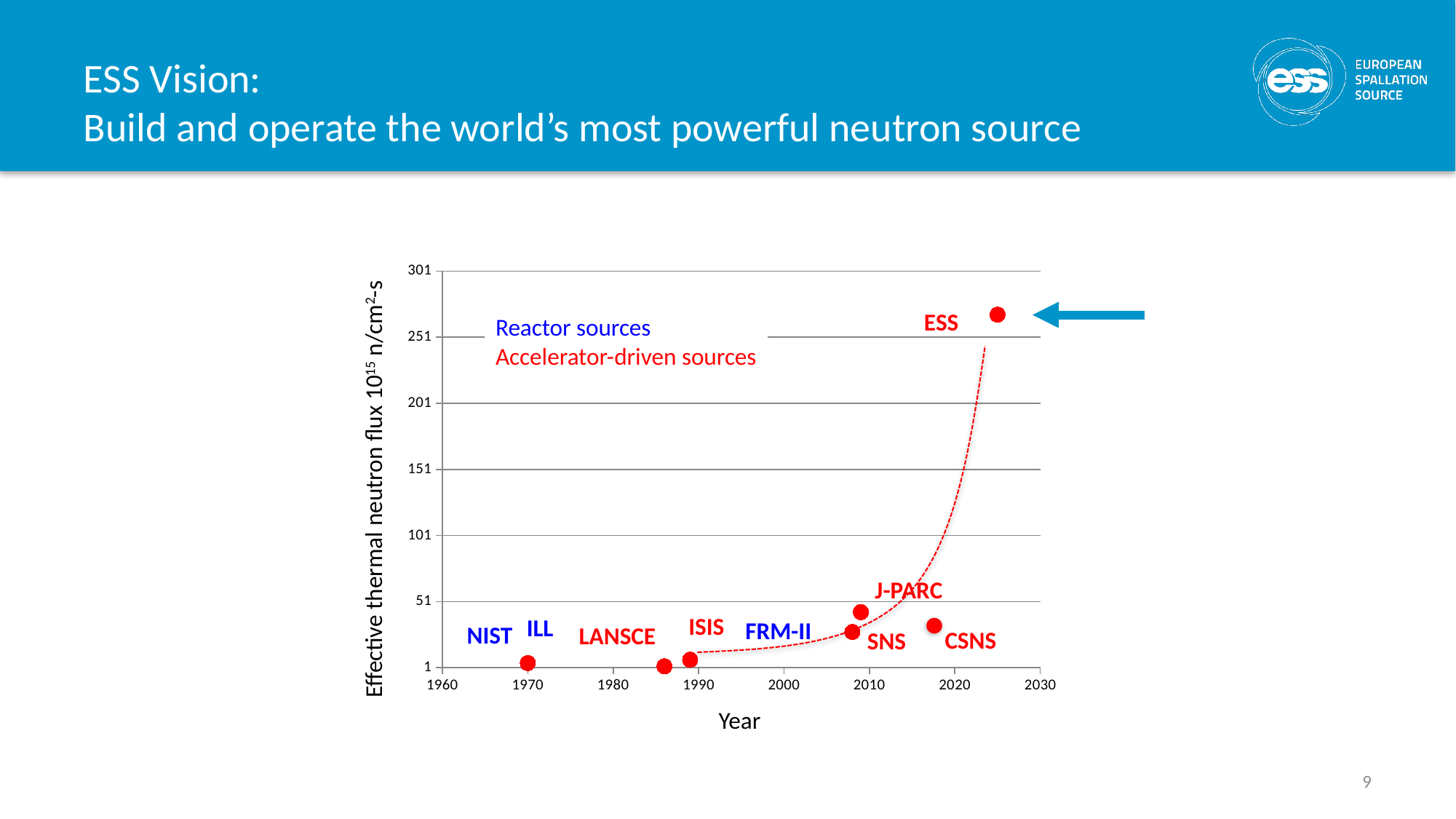
In what colour are the accelerator-driven sources labelled on the chart? red Which facility has the highest effective thermal neutron flux on the chart? ESS Which has the higher effective thermal neutron flux, J-PARC or SNS? J-PARC Which has the higher effective thermal neutron flux, J-PARC or CSNS? J-PARC Is the value for J-PARC greater or less than 51? less What is the label of the x axis of the chart? Year What kind of chart is shown on the slide? scatter chart Is the value for ESS greater or less than 251? greater Which has the higher effective thermal neutron flux, ESS or J-PARC? ESS Does the effective thermal neutron flux generally rise or fall as the year increases along the x axis? rise Is the value for ESS greater or less than 201? greater